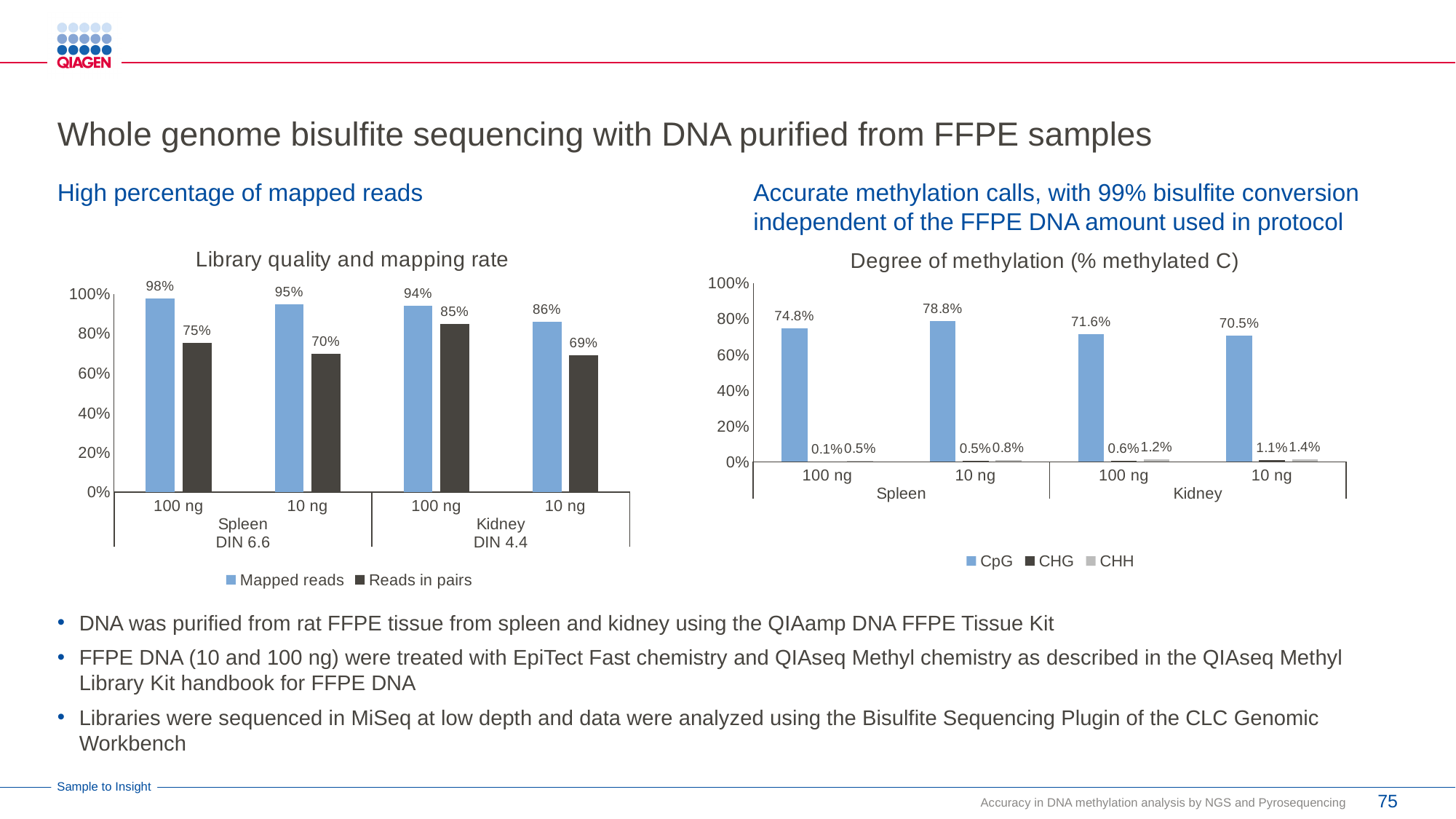
In the 'Degree of methylation (% methylated C)' chart, which is larger: the CHG value for Kidney 10 ng or the CHG value for Spleen 100 ng? Kidney 10 ng In the 'Library quality and mapping rate' chart, which category has the lowest Mapped reads value? Kidney 10 ng In the 'Library quality and mapping rate' chart, what kind of chart is shown? Bar chart In the 'Library quality and mapping rate' chart, what is the difference between Mapped reads and Reads in pairs for Spleen 10 ng? 25% In the 'Degree of methylation (% methylated C)' chart, how many series does the legend list? 3 In the 'Degree of methylation (% methylated C)' chart, what is the CpG value for Spleen 10 ng? 78.8% In the 'Library quality and mapping rate' chart, what is the Reads in pairs value for Kidney 100 ng? 85% In the 'Degree of methylation (% methylated C)' chart, which category has the highest CpG value? Spleen 10 ng In the 'Library quality and mapping rate' chart, how many series does the legend list? 2 In the 'Library quality and mapping rate' chart, what is the Mapped reads value for Spleen 100 ng? 98% In the 'Degree of methylation (% methylated C)' chart, what is the CHH value for Kidney 100 ng? 1.2% In the 'Degree of methylation (% methylated C)' chart, what is the difference between the CpG values for Spleen 100 ng and Kidney 10 ng? 4.3%